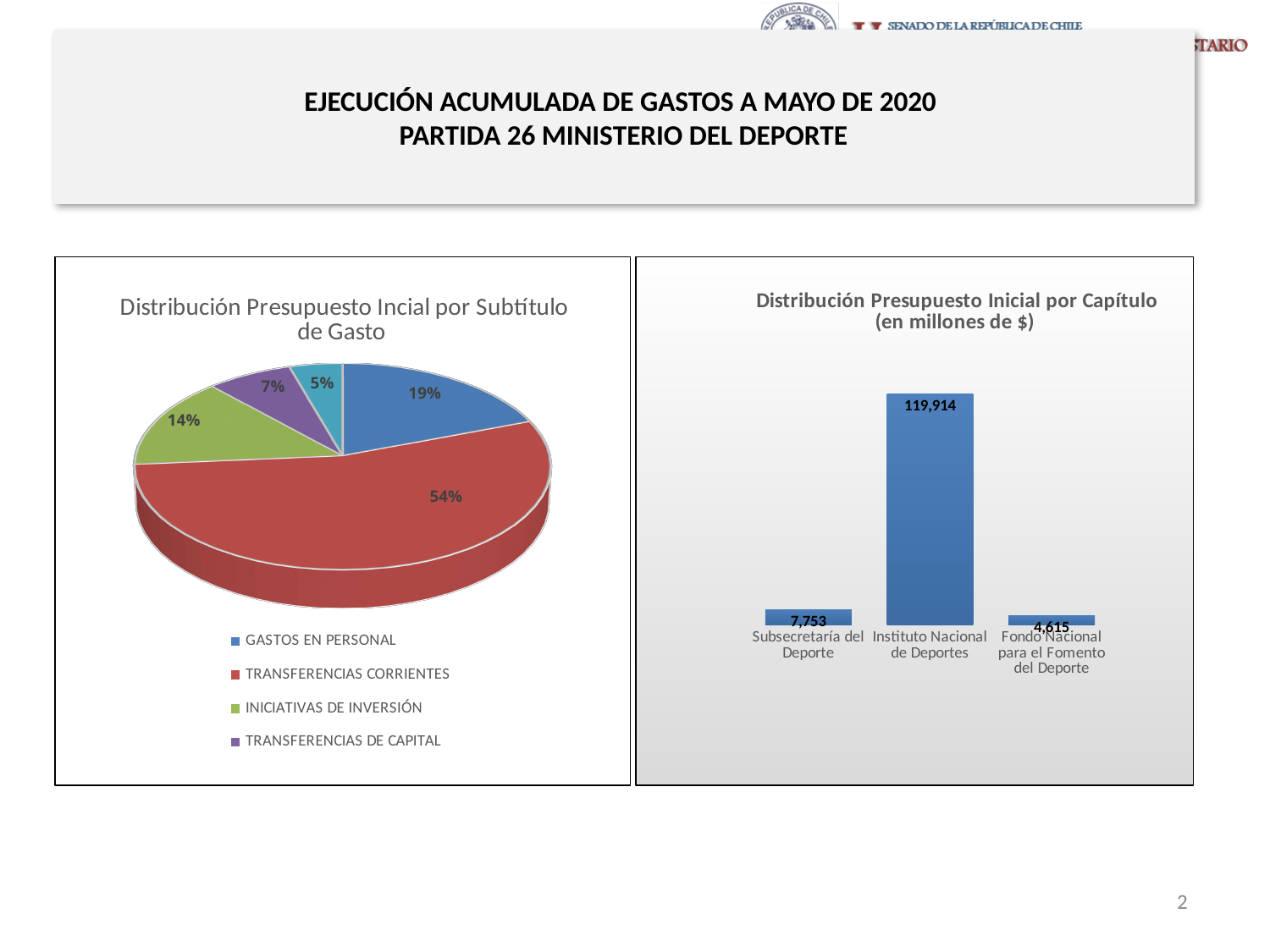
In the bar chart 'Distribución Presupuesto Inicial por Capítulo', what is the value for Fondo Nacional para el Fomento del Deporte? 4,615 What type of chart is the one on the left side of the slide? Pie chart In the pie chart 'Distribución Presupuesto Incial por Subtítulo de Gasto', what share does TRANSFERENCIAS CORRIENTES have? 54% In the bar chart 'Distribución Presupuesto Inicial por Capítulo', what is the value for Subsecretaría del Deporte? 7,753 In the bar chart 'Distribución Presupuesto Inicial por Capítulo', how many categories are shown? 3 In the bar chart 'Distribución Presupuesto Inicial por Capítulo', what is the difference between the values for Subsecretaría del Deporte and Fondo Nacional para el Fomento del Deporte? 3,138 In the bar chart 'Distribución Presupuesto Inicial por Capítulo', what is the value for Instituto Nacional de Deportes? 119,914 What type of chart is the one on the right side of the slide? Bar chart In the bar chart 'Distribución Presupuesto Inicial por Capítulo', which category has the highest value? Instituto Nacional de Deportes In the pie chart 'Distribución Presupuesto Incial por Subtítulo de Gasto', which is larger: INICIATIVAS DE INVERSIÓN or TRANSFERENCIAS DE CAPITAL? INICIATIVAS DE INVERSIÓN In the pie chart 'Distribución Presupuesto Incial por Subtítulo de Gasto', what share does GASTOS EN PERSONAL have? 19% In the bar chart 'Distribución Presupuesto Inicial por Capítulo', which category has the lowest value? Fondo Nacional para el Fomento del Deporte